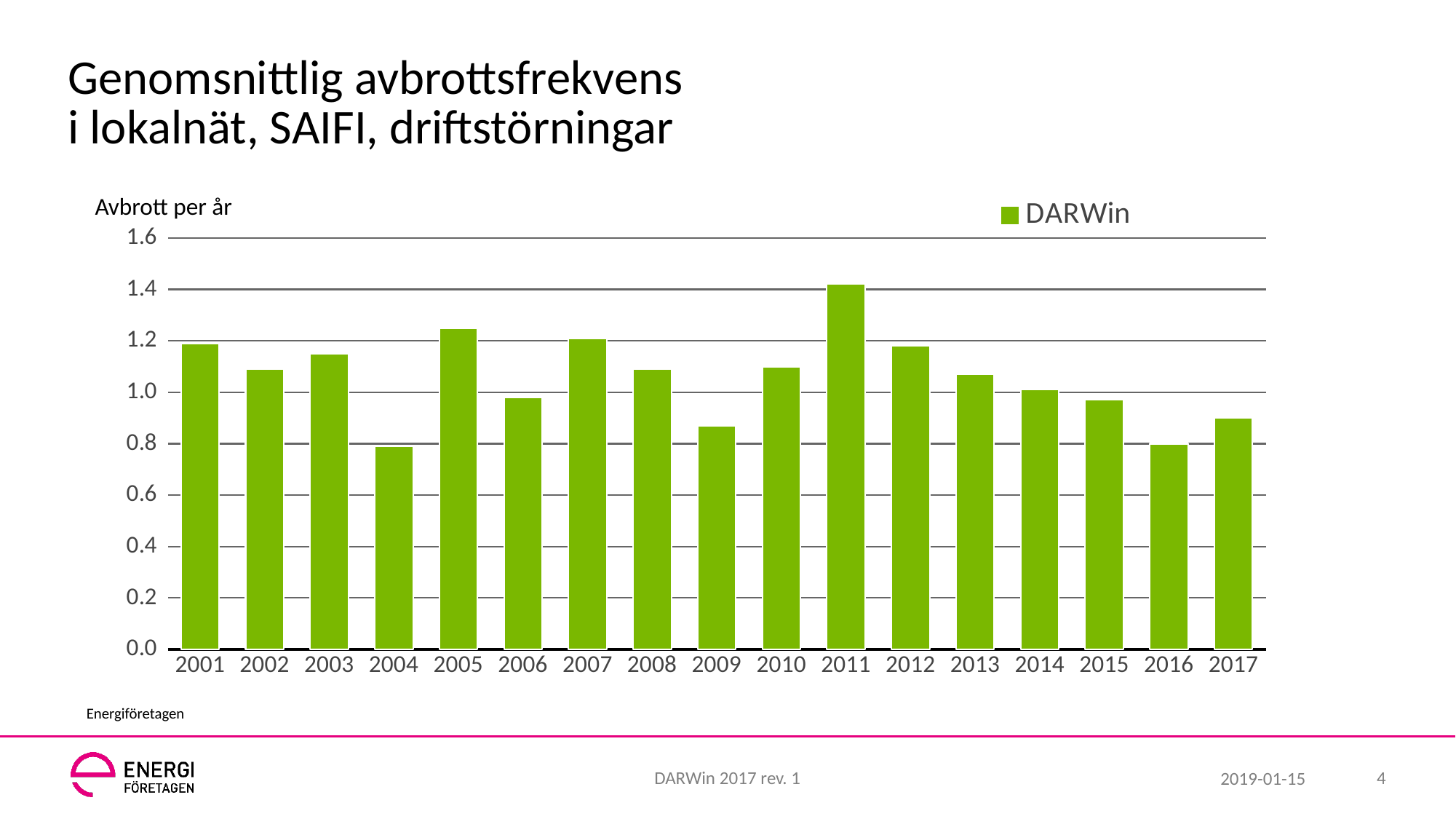
Is the value for 2013 greater or less than 1.0? greater Which year has the larger value, 2005 or 2009? 2005 Is the value for 2005 greater or less than 1.2? greater Is the value for 2009 greater or less than 1.0? less Which year has the larger value, 2001 or 2017? 2001 How many years are shown on the x axis of the chart? 17 Which year has the highest value in the chart? 2011 What kind of chart is shown on the slide? bar chart How many series does the chart's legend list? 1 What is the name of the series listed in the chart's legend? DARWin Do the values rise or fall from 2011 to 2016? fall